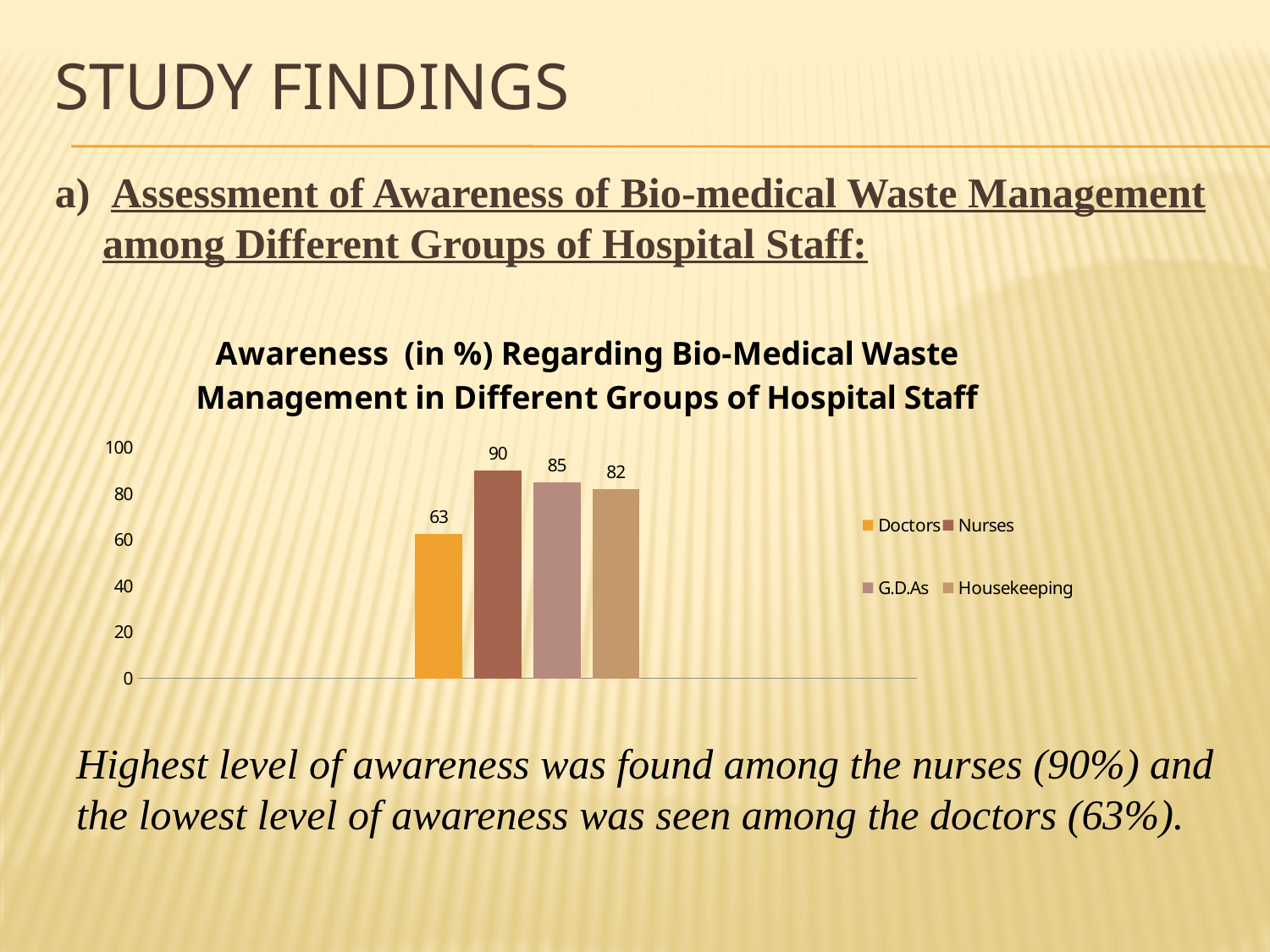
What kind of chart is shown on the slide? bar chart What is the awareness value for Doctors? 63 Which is larger, the value for G.D.As or the value for Housekeeping? G.D.As What is the awareness value for Housekeeping? 82 Which group has the highest awareness value? Nurses How many series does the legend list? 4 What is the awareness value for Nurses? 90 What is the difference between the awareness values for Nurses and Doctors? 27 What is the title of the chart? Awareness (in %) Regarding Bio-Medical Waste Management in Different Groups of Hospital Staff What is the awareness value for G.D.As? 85 Is the value for Doctors greater or less than 80? less Which group has the lowest awareness value? Doctors